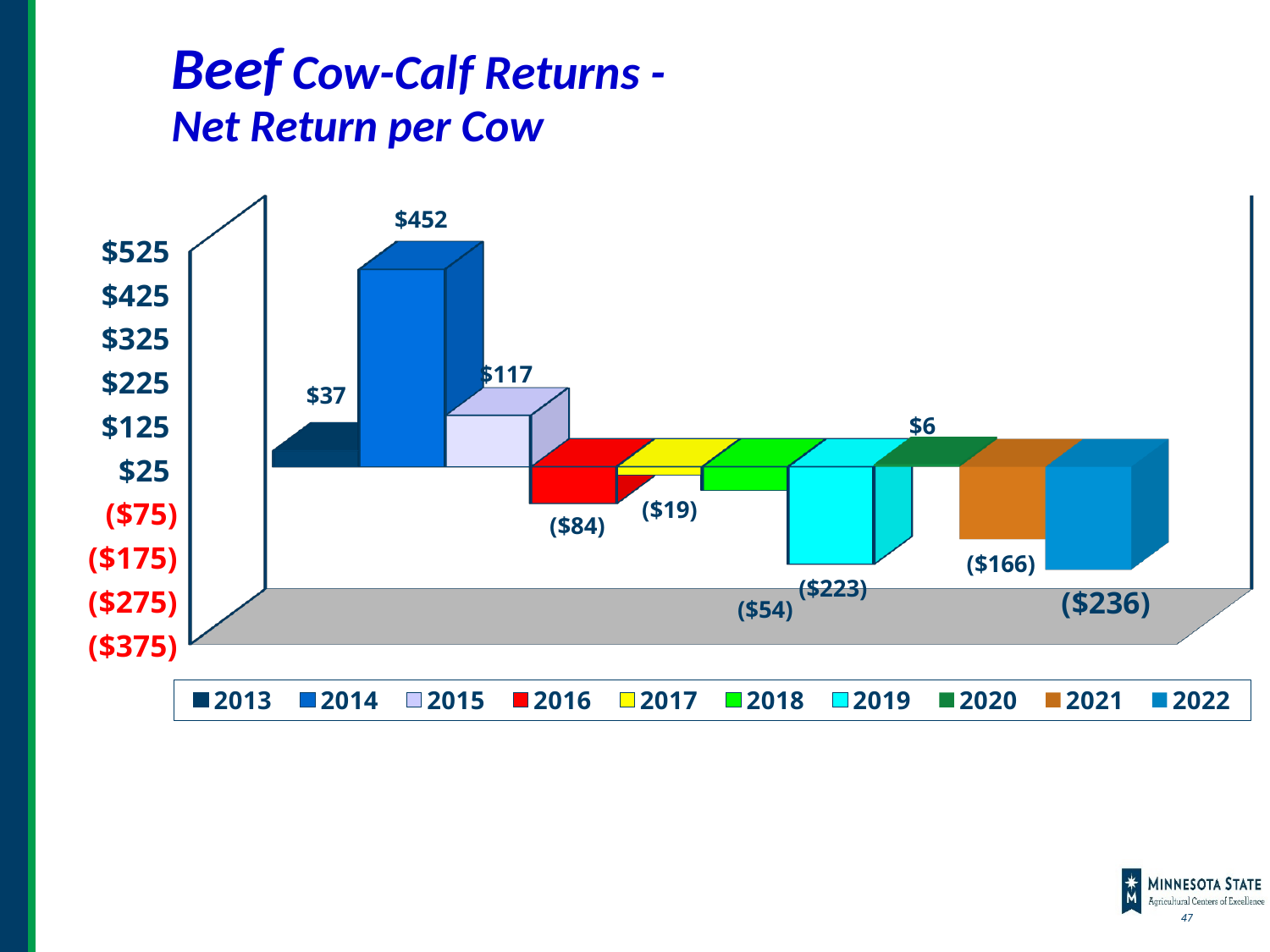
Which year has the lowest net return per cow? 2022 What is the net return per cow for 2019? ($223) Which year has the larger net return per cow, 2013 or 2020? 2013 How many years are shown in the chart? 10 What is the net return per cow for 2013? $37 What is the difference between the net return per cow in 2014 and in 2015? $335 What is the net return per cow for 2014? $452 What is the net return per cow for 2022? ($236) What kind of chart is shown on the slide? Bar chart What is the net return per cow for 2020? $6 What is the title of the chart on the slide? Beef Cow-Calf Returns - Net Return per Cow Which year has the highest net return per cow? 2014